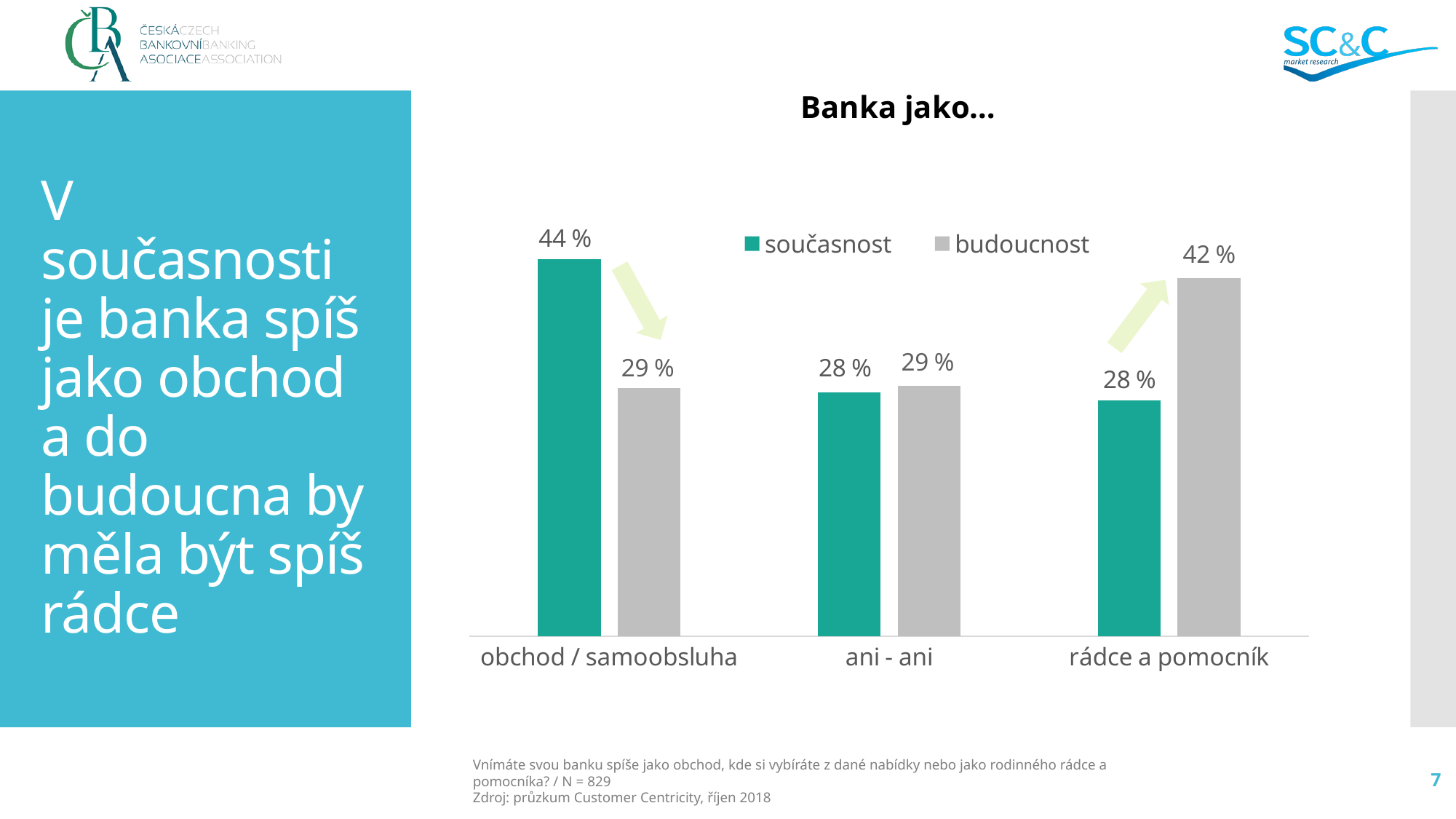
What is the difference between the 'budoucnost' and 'současnost' values for 'rádce a pomocník'? 14 % Which category has the highest 'současnost' value? obchod / samoobsluha What is the difference between the 'současnost' and 'budoucnost' values for 'obchod / samoobsluha'? 15 % What is the value for 'budoucnost' in the 'rádce a pomocník' category? 42 % What is the value for 'budoucnost' in the 'ani - ani' category? 29 % Which category has the lowest 'budoucnost' value? obchod / samoobsluha How many series does the legend list? 2 How many categories are shown on the x axis? 3 What is the value for 'současnost' in the 'rádce a pomocník' category? 28 % What kind of chart is shown on the slide? bar chart Which is larger for 'rádce a pomocník': the 'současnost' value or the 'budoucnost' value? budoucnost What is the value for 'současnost' in the 'obchod / samoobsluha' category? 44 %